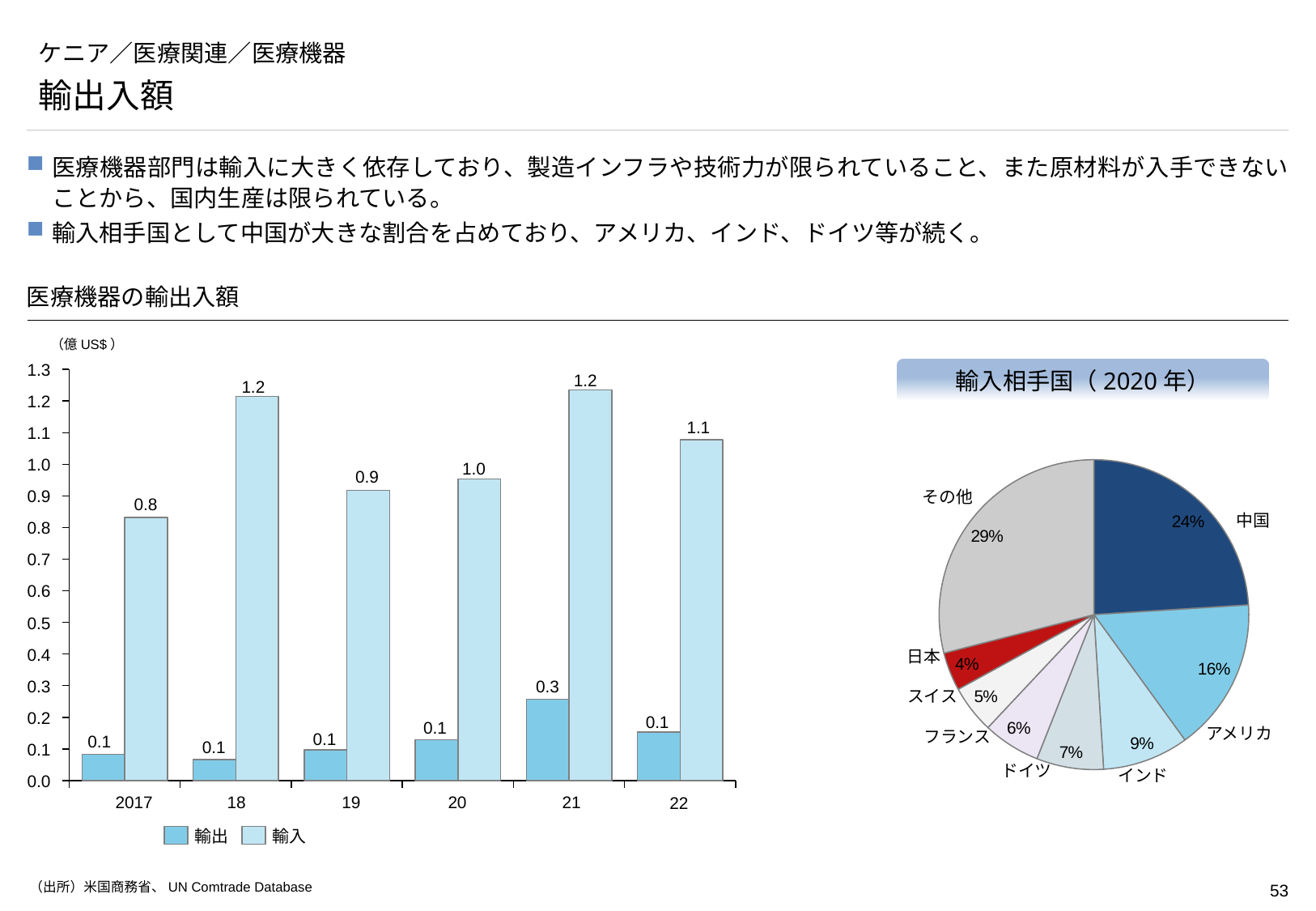
In the pie chart 輸入相手国（2020年）, how many slices are there? 8 In the pie chart 輸入相手国（2020年）, what share does 中国 have? 24% In the pie chart 輸入相手国（2020年）, which named country has the smallest share? 日本 What kind of chart is 医療機器の輸出入額? bar chart In the bar chart 医療機器の輸出入額, what is the value of 輸出 for 21? 0.3 In the bar chart 医療機器の輸出入額, which year has the lowest 輸入 value? 2017 In the bar chart 医療機器の輸出入額, how many series does the legend list? 2 In the bar chart 医療機器の輸出入額, what is the value of 輸入 for 2017? 0.8 In the bar chart 医療機器の輸出入額, what is the difference between 輸入 and 輸出 in 21? 0.9 In the bar chart 医療機器の輸出入額, which year has the highest 輸出 value? 21 In the bar chart 医療機器の輸出入額, is the 輸入 value for 18 larger or smaller than the 輸入 value for 19? larger In the bar chart 医療機器の輸出入額, how many years are shown on the x axis? 6